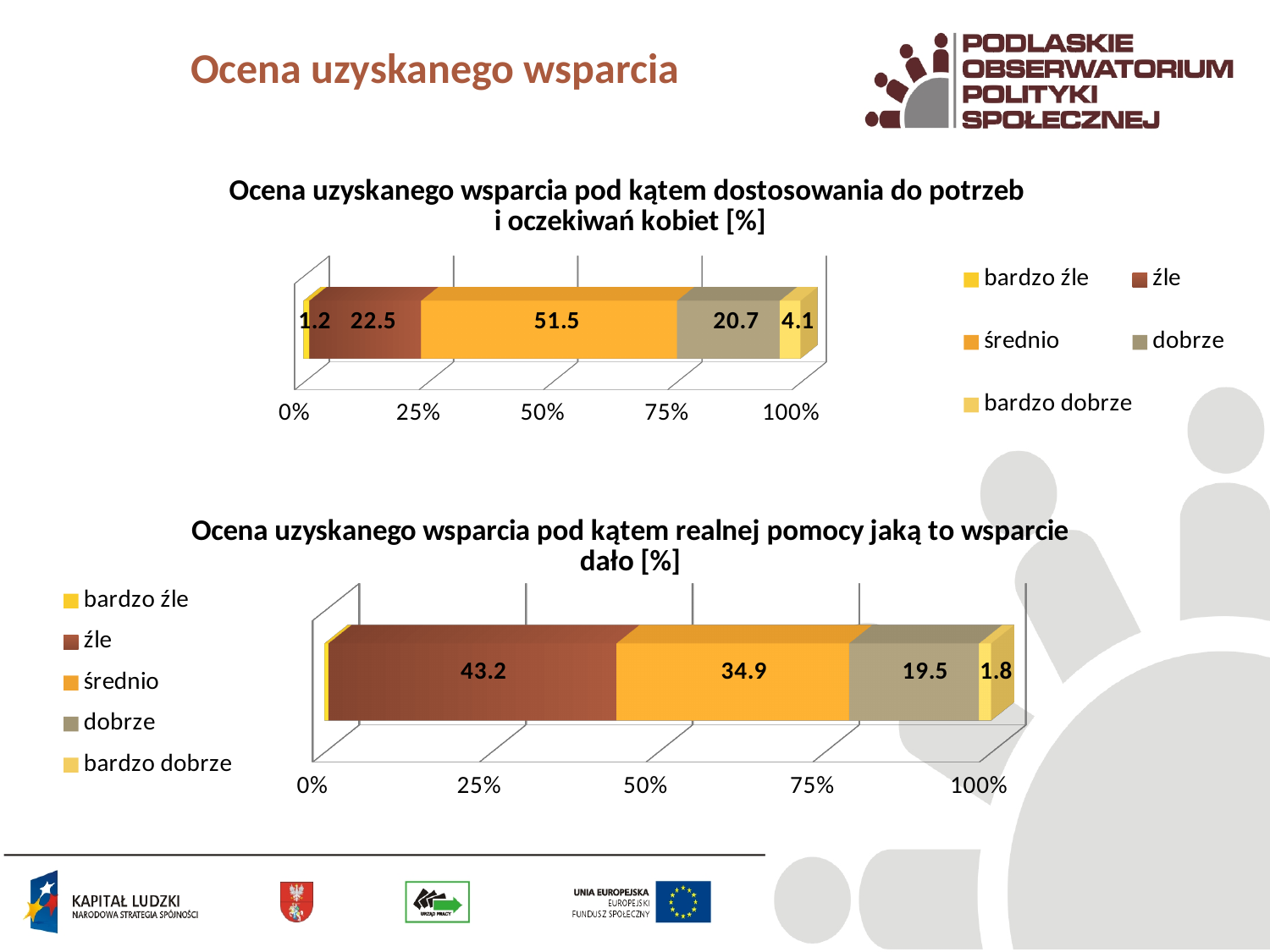
In the bottom chart (realnej pomocy jaką to wsparcie dało), is the value for "źle" greater or less than 25%? greater In the top chart (dostosowania do potrzeb i oczekiwań kobiet), which category has the lowest value? bardzo źle What kind of chart is the bottom chart (realnej pomocy jaką to wsparcie dało)? stacked bar chart In the bottom chart (realnej pomocy jaką to wsparcie dało), which is larger, the value for "źle" or the value for "średnio"? źle In the bottom chart (realnej pomocy jaką to wsparcie dało), what is the value for "źle"? 43.2 In the top chart (dostosowania do potrzeb i oczekiwań kobiet), what is the difference between the values for "źle" and "dobrze"? 1.8 In the bottom chart (realnej pomocy jaką to wsparcie dało), what is the difference between the values for "średnio" and "dobrze"? 15.4 In the top chart (dostosowania do potrzeb i oczekiwań kobiet), what is the value for "średnio"? 51.5 How many series does the legend of the top chart list? 5 In the bottom chart (realnej pomocy jaką to wsparcie dało), what is the value for "dobrze"? 19.5 In the top chart (dostosowania do potrzeb i oczekiwań kobiet), which category has the highest value? średnio In the top chart (dostosowania do potrzeb i oczekiwań kobiet), what is the value for "bardzo dobrze"? 4.1